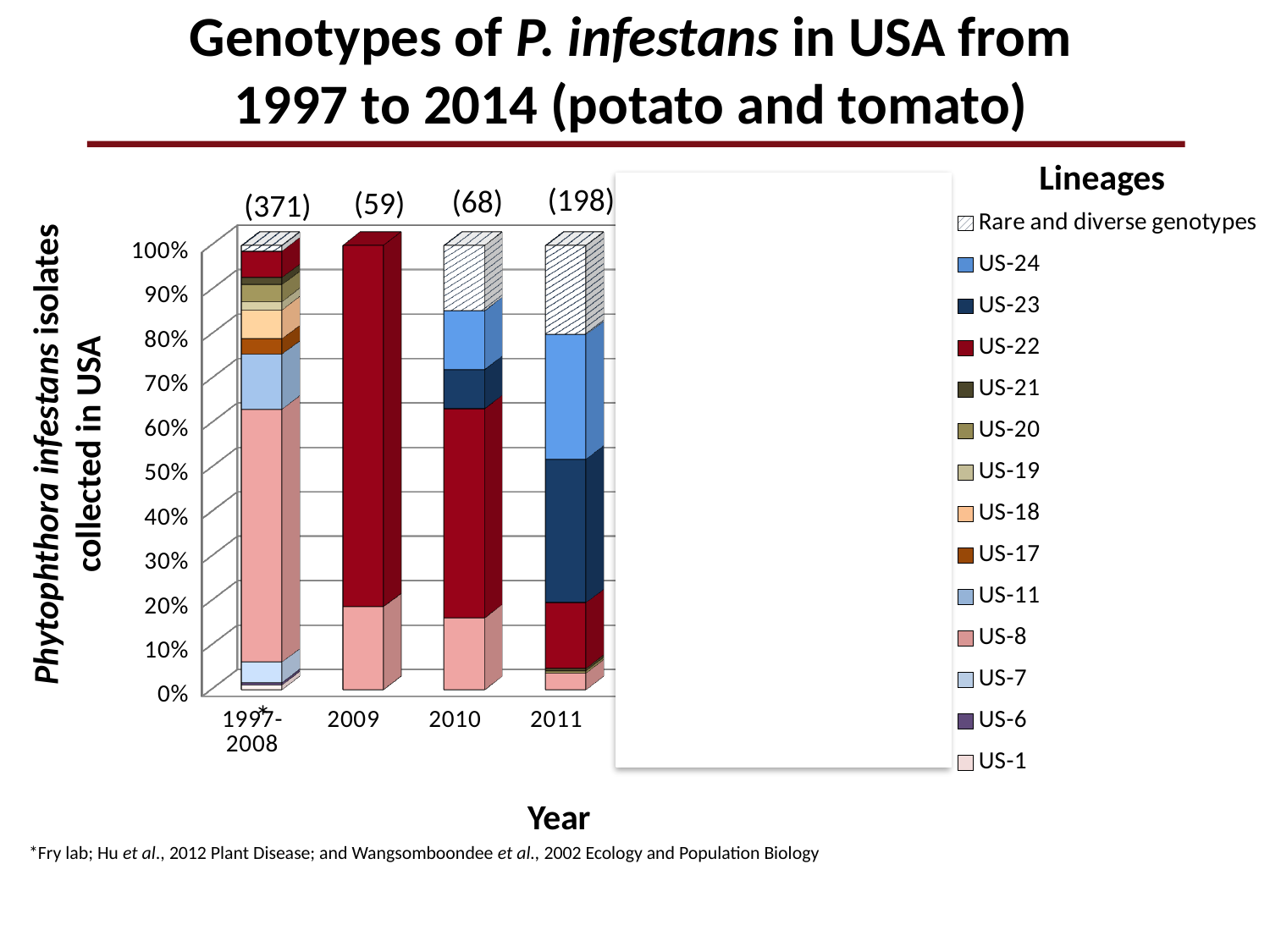
Which year has more isolates, 2009 or 2011? 2011 What type of chart is shown on the slide? Stacked bar chart How many isolates were collected in 2011, according to the number printed above the bar? 198 Is the share of US-8 in the 1997-2008 bar greater or less than 40%? greater Is the share of US-22 in the 2009 bar greater or less than 70%? greater What is the title of the legend? Lineages Which visible year group has the smallest number of isolates printed above its bar? 2009 How many isolates were collected in 2009, according to the number printed above the bar? 59 How many isolates were collected in the 1997-2008 period, according to the number printed above the bar? 371 Is the share of Rare and diverse genotypes in the 2010 bar greater or less than 20%? less Which visible year group has the largest number of isolates printed above its bar? 1997-2008 How many lineages does the legend list? 14